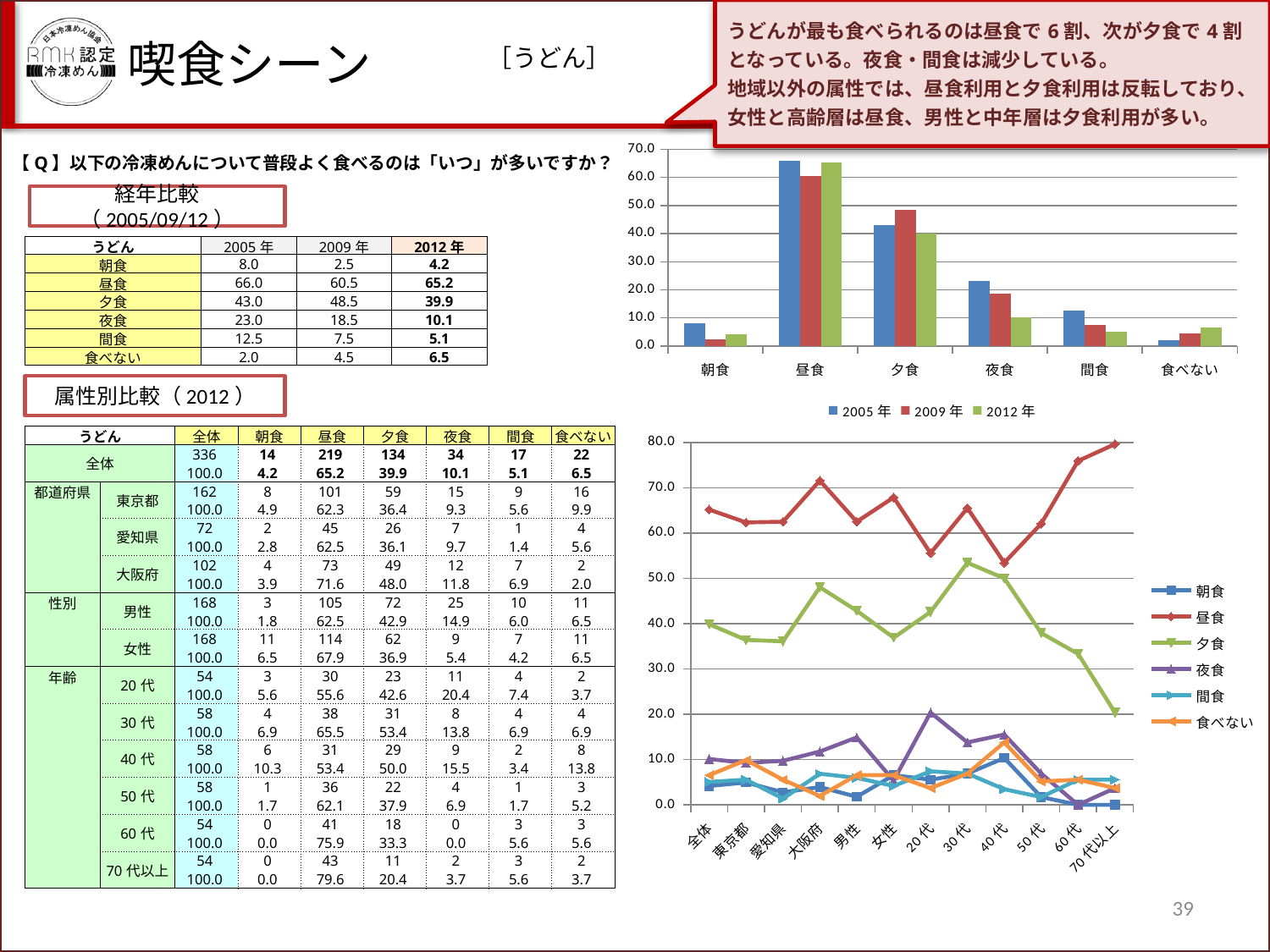
What kind of chart is the bottom-right chart with categories from 全体 to 70代以上? line chart In the top-right bar chart, which is larger for 朝食: the 2005年 value or the 2012年 value? 2005年 In the top-right bar chart, how many categories are shown on the x axis? 6 In the top-right bar chart, how many series does the legend list? 3 In the bottom-right line chart, how many series does the legend list? 6 In the top-right bar chart, which category has the lowest value for 2005年? 食べない In the top-right bar chart, which category has the highest value for 2012年? 昼食 What kind of chart is the top-right chart comparing 2005年, 2009年 and 2012年? bar chart In the top-right bar chart, is the 2012年 value for 夜食 greater or less than 20.0? less In the bottom-right line chart, is the 夕食 value for 60代 greater or less than 40.0? less In the top-right bar chart, is the 2012年 value for 昼食 greater or less than 60.0? greater In the top-right bar chart, do the values for 夜食 rise or fall from 2005年 to 2012年? fall